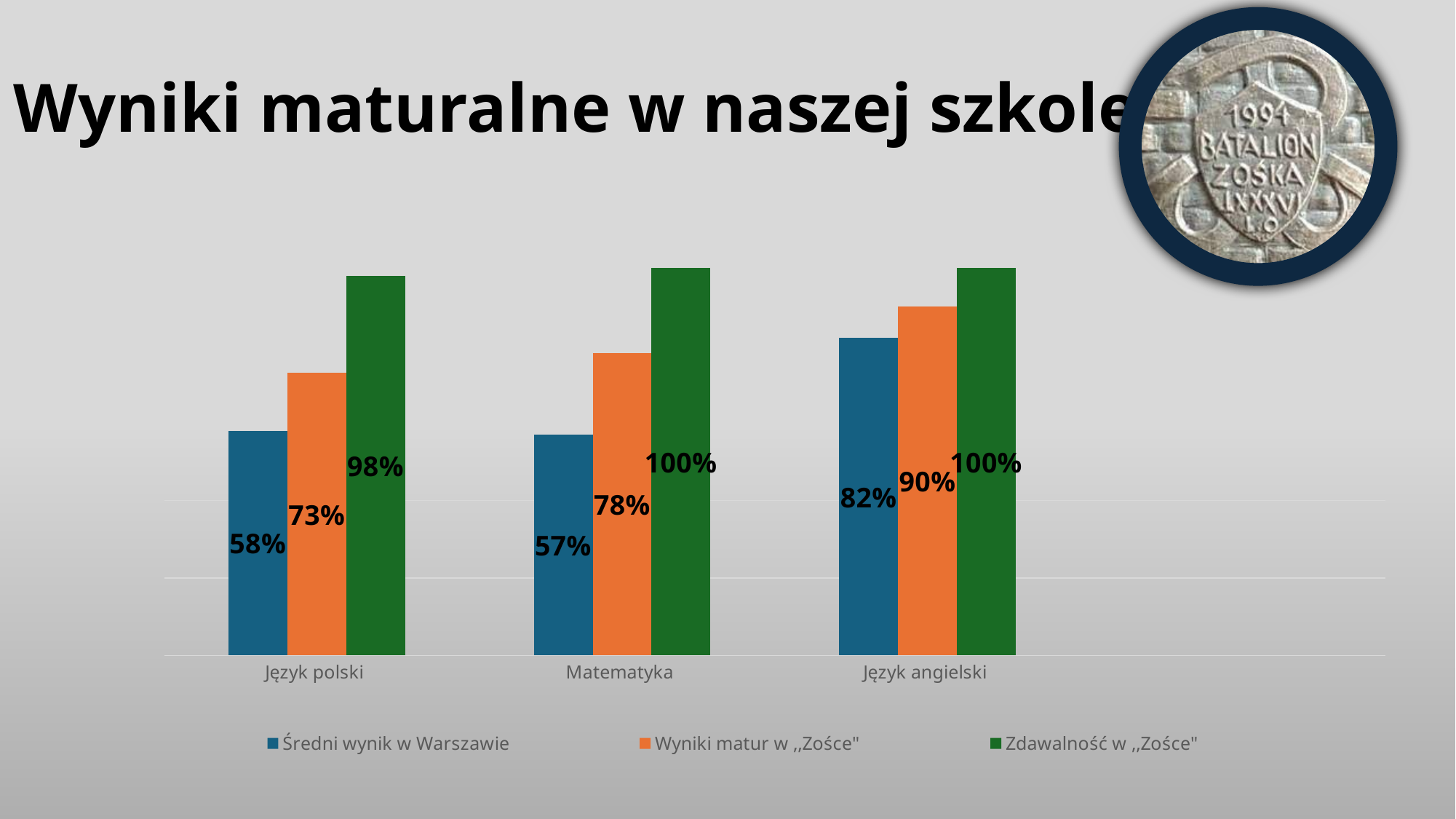
What is the title of the slide? Wyniki maturalne w naszej szkole What is the value of "Wyniki matur w ,,Zośce"" for Język angielski? 90% How many subjects are shown on the x axis? 3 What kind of chart is shown on the slide? Bar chart Which subject has the lowest value for "Wyniki matur w ,,Zośce""? Język polski What is the value of "Średni wynik w Warszawie" for Język polski? 58% How many series does the legend list? 3 What is the difference between "Wyniki matur w ,,Zośce"" and "Średni wynik w Warszawie" for Matematyka? 21% Which is larger for Język angielski: "Średni wynik w Warszawie" or "Wyniki matur w ,,Zośce""? Wyniki matur w ,,Zośce" What is the value of "Zdawalność w ,,Zośce"" for Język polski? 98% What is the value of "Wyniki matur w ,,Zośce"" for Matematyka? 78% Which subject has the highest value for "Średni wynik w Warszawie"? Język angielski